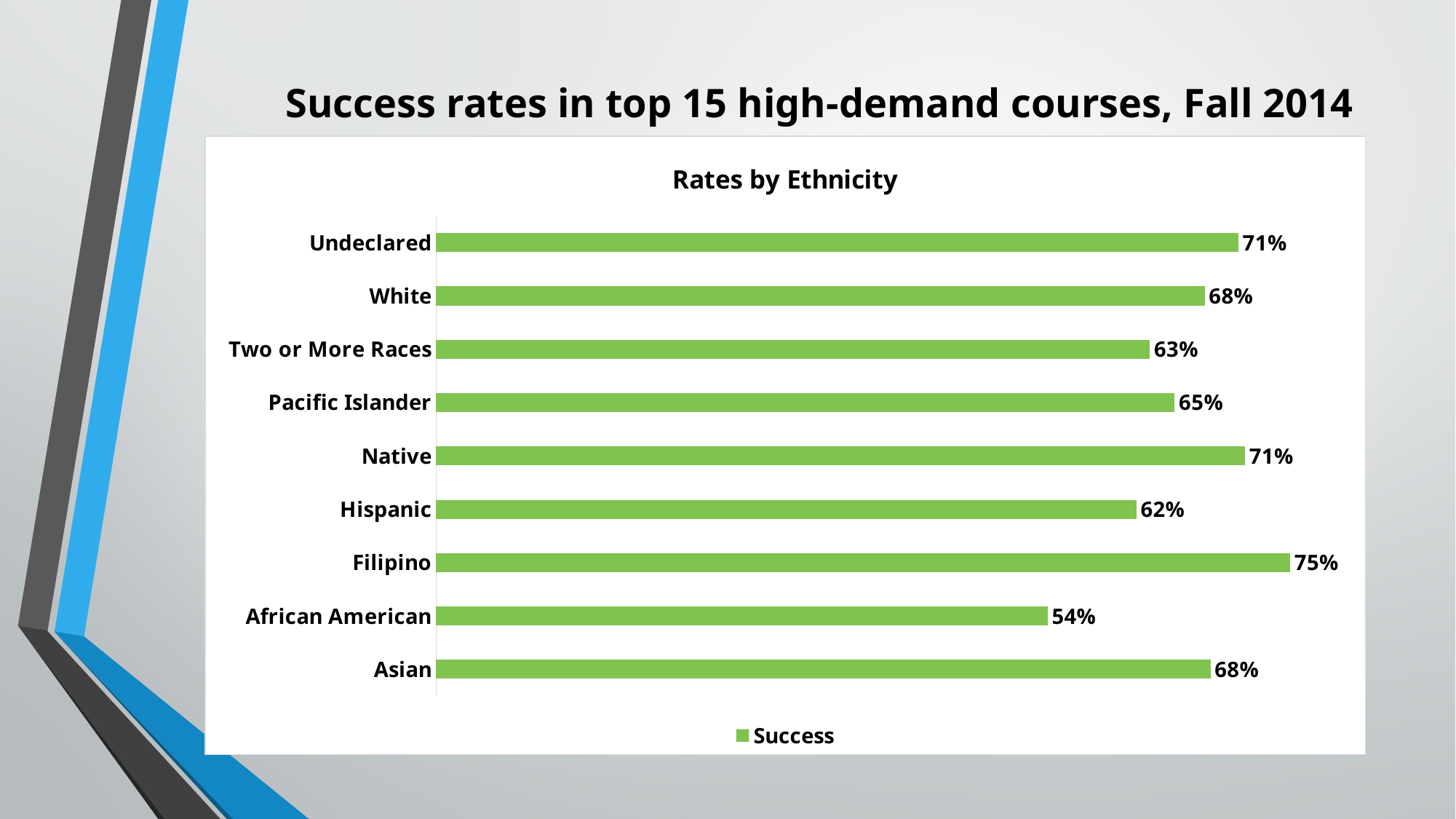
What kind of chart is shown on the slide? Bar chart What is the success rate for Hispanic students? 62% What is the success rate for African American students? 54% Which ethnicity has the lowest success rate? African American What is the difference between the success rates for White and Two or More Races? 5% What is the difference between the success rates for Filipino and African American students? 21% What is the success rate for Pacific Islander students? 65% Which has a higher success rate, Hispanic or Pacific Islander? Pacific Islander How many ethnicity categories are shown in the chart? 9 What is the success rate for Filipino students? 75% What is the title of the chart? Rates by Ethnicity Which ethnicity has the highest success rate? Filipino